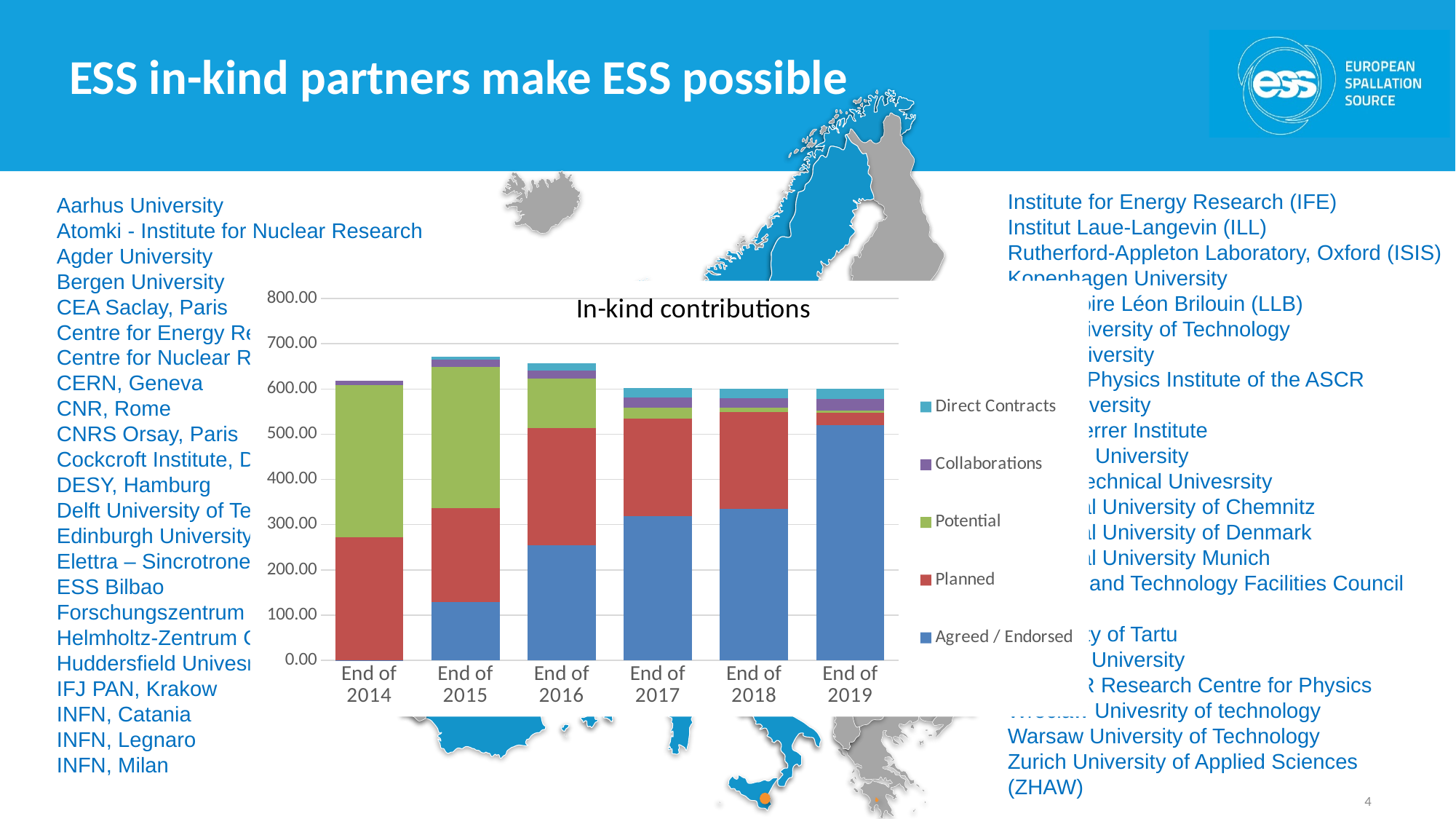
Does the Agreed / Endorsed portion rise or fall from End of 2014 to End of 2019? rise Is the Agreed / Endorsed value for End of 2015 greater or less than 200? less Is the total stacked value for End of 2015 greater or less than 600? greater Is the Agreed / Endorsed value larger at End of 2017 or at End of 2016? End of 2017 What is the title of the chart? In-kind contributions Which series is shown in green in the chart? Potential Is the Agreed / Endorsed value for End of 2019 greater or less than 500? greater Which year has the largest Potential segment? End of 2014 How many series does the chart legend list? 5 What kind of chart is shown on the slide? stacked bar chart How many time points (categories) are shown on the x axis of the chart? 6